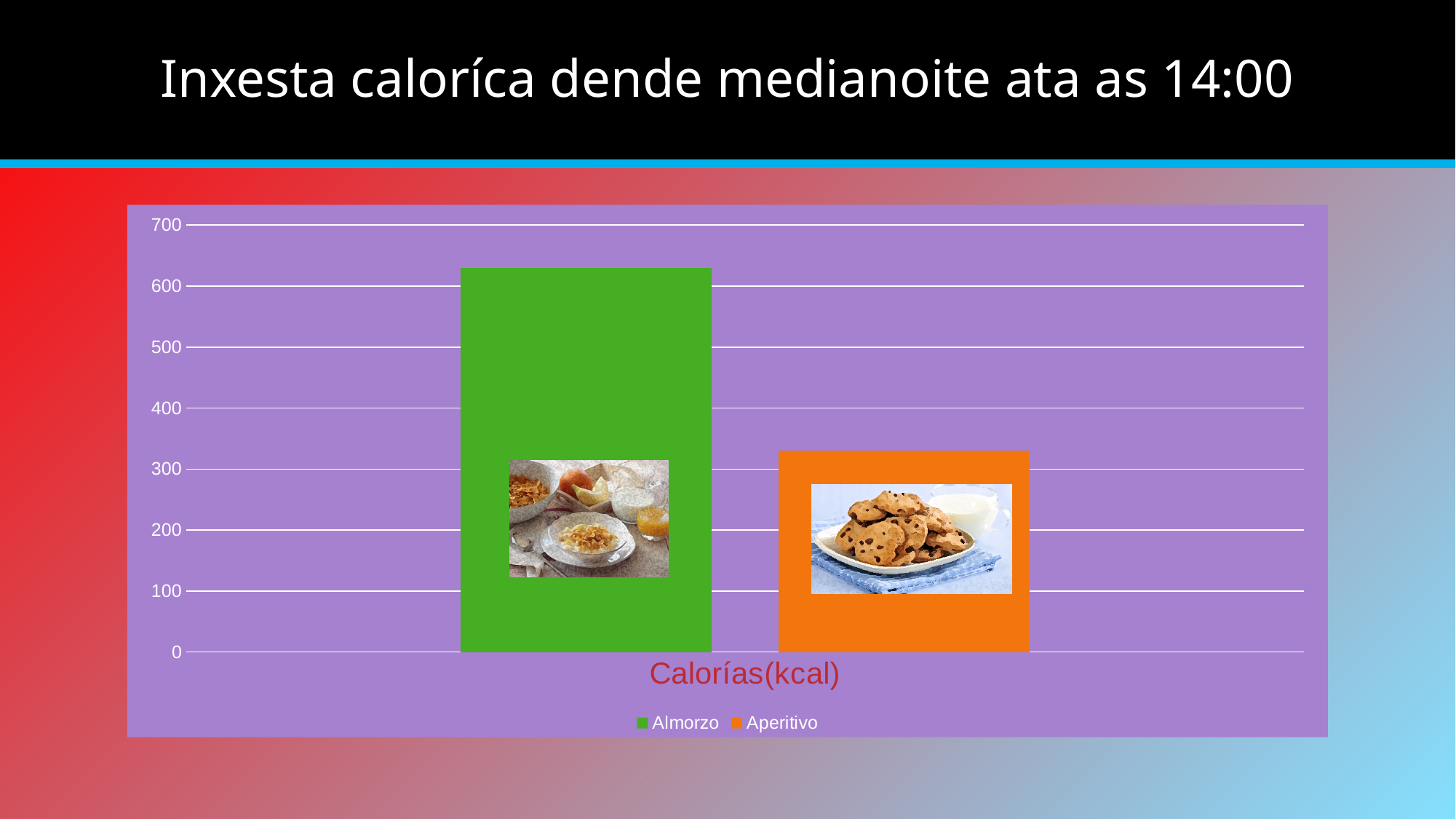
Is the value for Almorzo greater or less than 600? greater Which series has the highest value? Almorzo Which series has the lowest value? Aperitivo What kind of chart is shown on the slide? bar chart Which is larger, the value for Almorzo or the value for Aperitivo? Almorzo Is the value for Aperitivo greater or less than 400? less What colour is the bar for Aperitivo? orange How many series does the legend list? 2 How many categories are shown on the x axis? 1 What is the label of the category on the x axis? Calorías(kcal) Is the value for Almorzo greater or less than 700? less